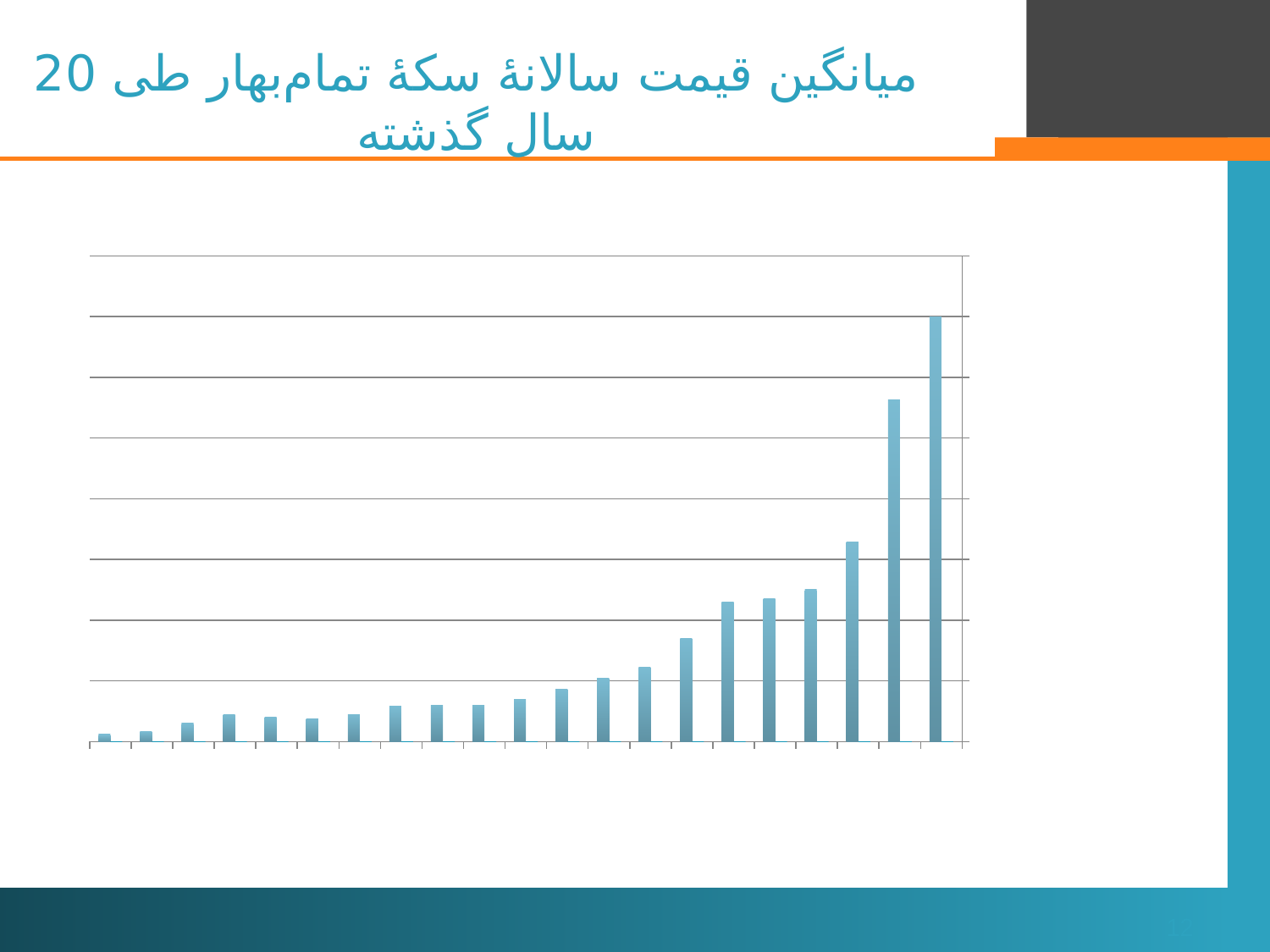
Which is taller, the leftmost bar or the rightmost bar? the rightmost bar What colour are the bars in the chart? blue Which bar is the tallest in the chart? the rightmost bar What kind of chart is shown on the slide? bar chart Which bar is the shortest in the chart? the leftmost bar Which is taller, the third bar from the right or the fourth bar from the right? the third bar from the right How many bars are plotted in the chart? 21 Does the chart display a legend? No Do the bar values generally rise or fall from left to right along the x axis? rise Which is taller, the rightmost bar or the second bar from the right? the rightmost bar